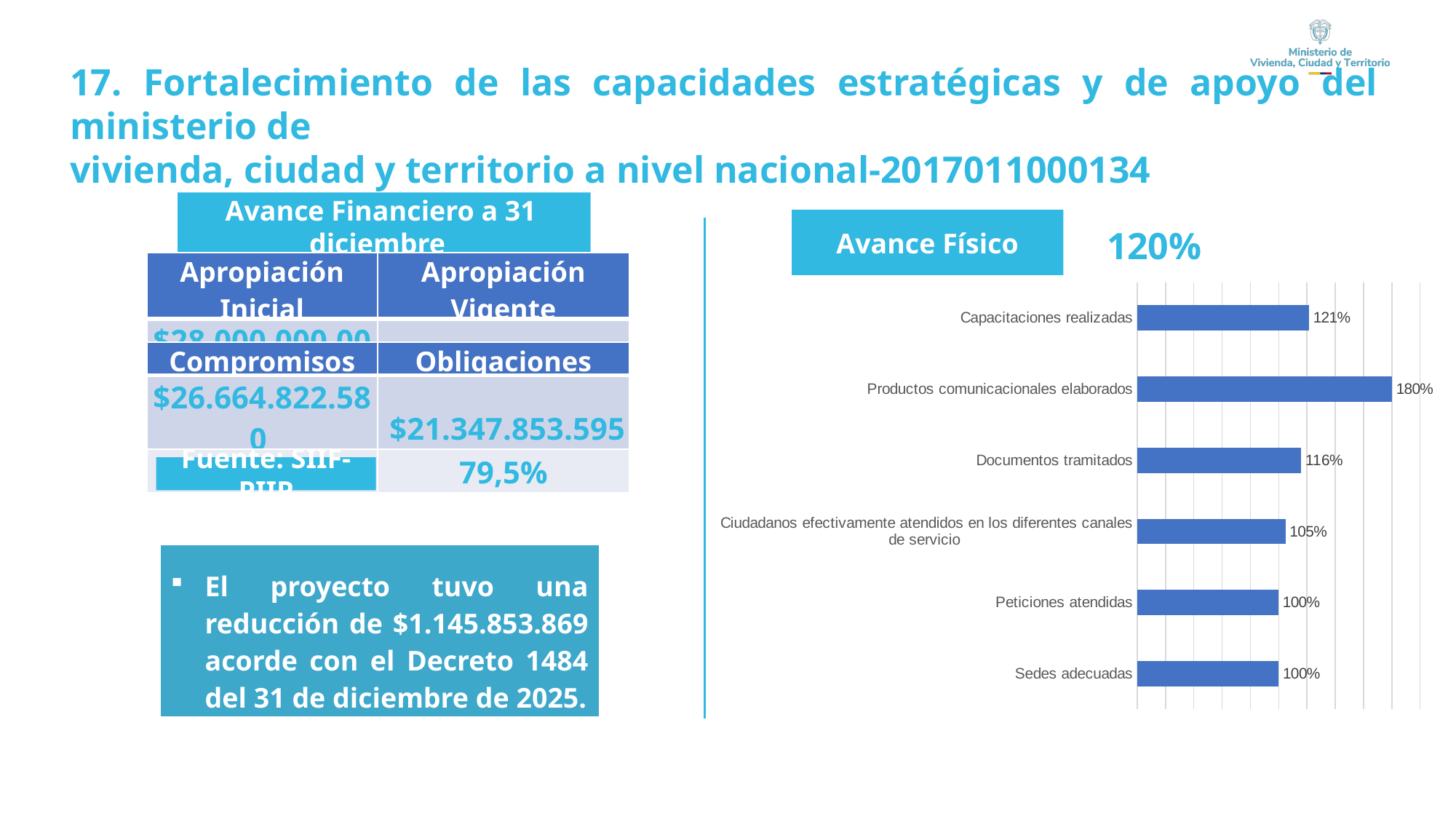
What is the value for "Documentos tramitados"? 116% What is the difference between the values for "Productos comunicacionales elaborados" and "Capacitaciones realizadas"? 59% What is the difference between the values for "Capacitaciones realizadas" and "Sedes adecuadas"? 21% What overall percentage is shown next to the "Avance Físico" heading? 120% What is the value for "Peticiones atendidas"? 100% Which category has the highest value in the "Avance Físico" chart? Productos comunicacionales elaborados What is the value for "Productos comunicacionales elaborados"? 180% What is the value for "Capacitaciones realizadas"? 121% Which is larger, the value for "Documentos tramitados" or the value for "Ciudadanos efectivamente atendidos en los diferentes canales de servicio"? Documentos tramitados What is the value for "Ciudadanos efectivamente atendidos en los diferentes canales de servicio"? 105% What type of chart is shown under "Avance Físico"? bar chart How many categories are plotted in the "Avance Físico" chart? 6